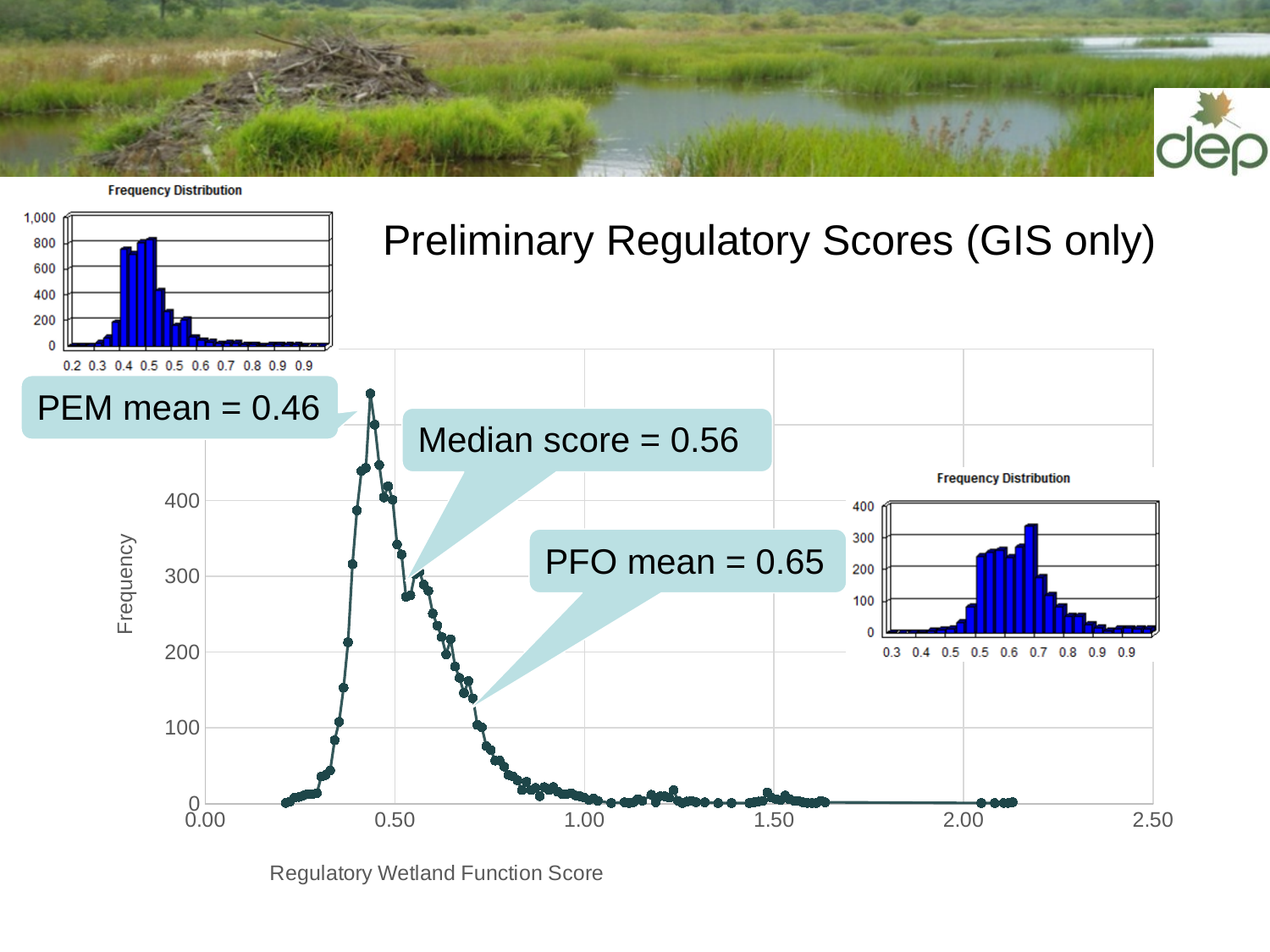
On the large central chart, what is the difference between the PFO mean and the PEM mean? 0.19 On the large central chart, what is the PEM mean shown in the callout? 0.46 What is the y-axis title of the large chart in the centre of the slide? Frequency On the large central chart, is the frequency at a score of 1.00 greater or less than 100? less On the large central chart, which is larger, the PFO mean or the PEM mean? PFO mean What kind of chart is the small 'Frequency Distribution' chart in the top-left corner of the slide? bar chart On the large central chart, what is the median score shown in the callout? 0.56 What is the x-axis title of the large chart in the centre of the slide? Regulatory Wetland Function Score On the large central chart, do the frequencies rise or fall as the score increases from 0.50 to 1.00? fall On the large central chart, what is the PFO mean shown in the callout? 0.65 On the small 'Frequency Distribution' chart on the right side of the slide, is the tallest bar greater or less than 300? greater On the large central chart, is the peak frequency greater or less than 400? greater